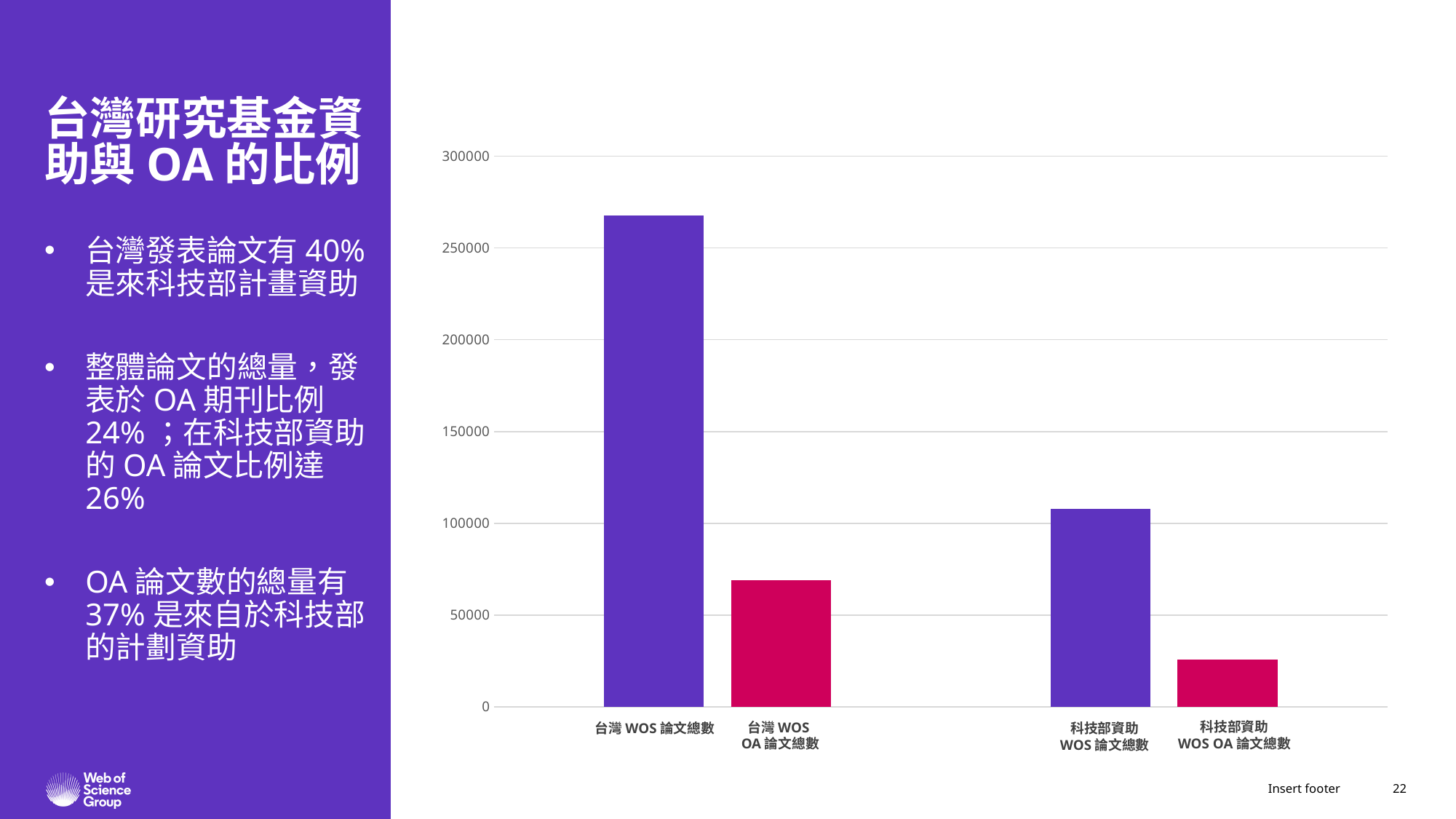
What colour are the bars for the OA 論文總數 categories? magenta (pink-red) Which category has the lowest value in the chart? 科技部資助 WOS OA 論文總數 What is the highest value shown on the vertical axis of the chart? 300000 Is the value for 科技部資助 WOS OA 論文總數 greater or less than 50000? less Which is larger, the value for 台灣 WOS OA 論文總數 or the value for 科技部資助 WOS 論文總數? 科技部資助 WOS 論文總數 How many bars are plotted in the chart? 4 Which category has the highest value in the chart? 台灣 WOS 論文總數 What kind of chart is shown on the slide? bar chart Which is larger, the value for 台灣 WOS 論文總數 or the value for 科技部資助 WOS 論文總數? 台灣 WOS 論文總數 Is the value for 科技部資助 WOS 論文總數 greater or less than 100000? greater Is the value for 台灣 WOS 論文總數 greater or less than 250000? greater